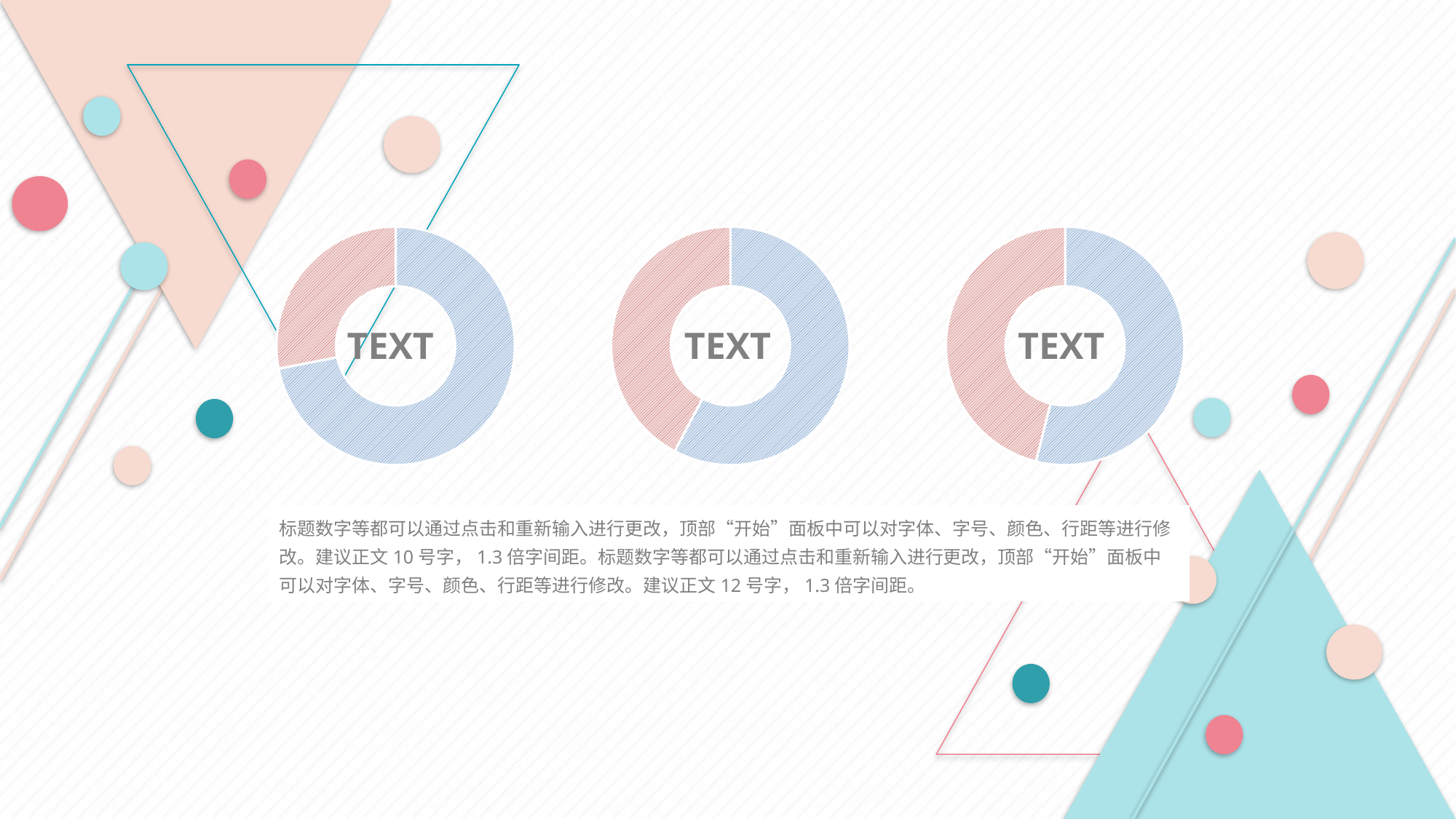
In the left chart, how many slices does the ring contain? 2 What kind of chart is the middle chart on the slide? doughnut chart In the right chart, which slice is larger, the pink one or the blue one? blue How many charts are shown on the slide? 3 Does the left chart display a legend? No In the right chart, how many slices does the ring contain? 2 What word is printed in the centre of each doughnut chart? TEXT In the middle chart, which slice is larger, the pink one or the blue one? blue What kind of chart is the right chart on the slide? doughnut chart In the left chart, which slice is larger, the pink one or the blue one? blue What kind of chart is the left chart on the slide? doughnut chart